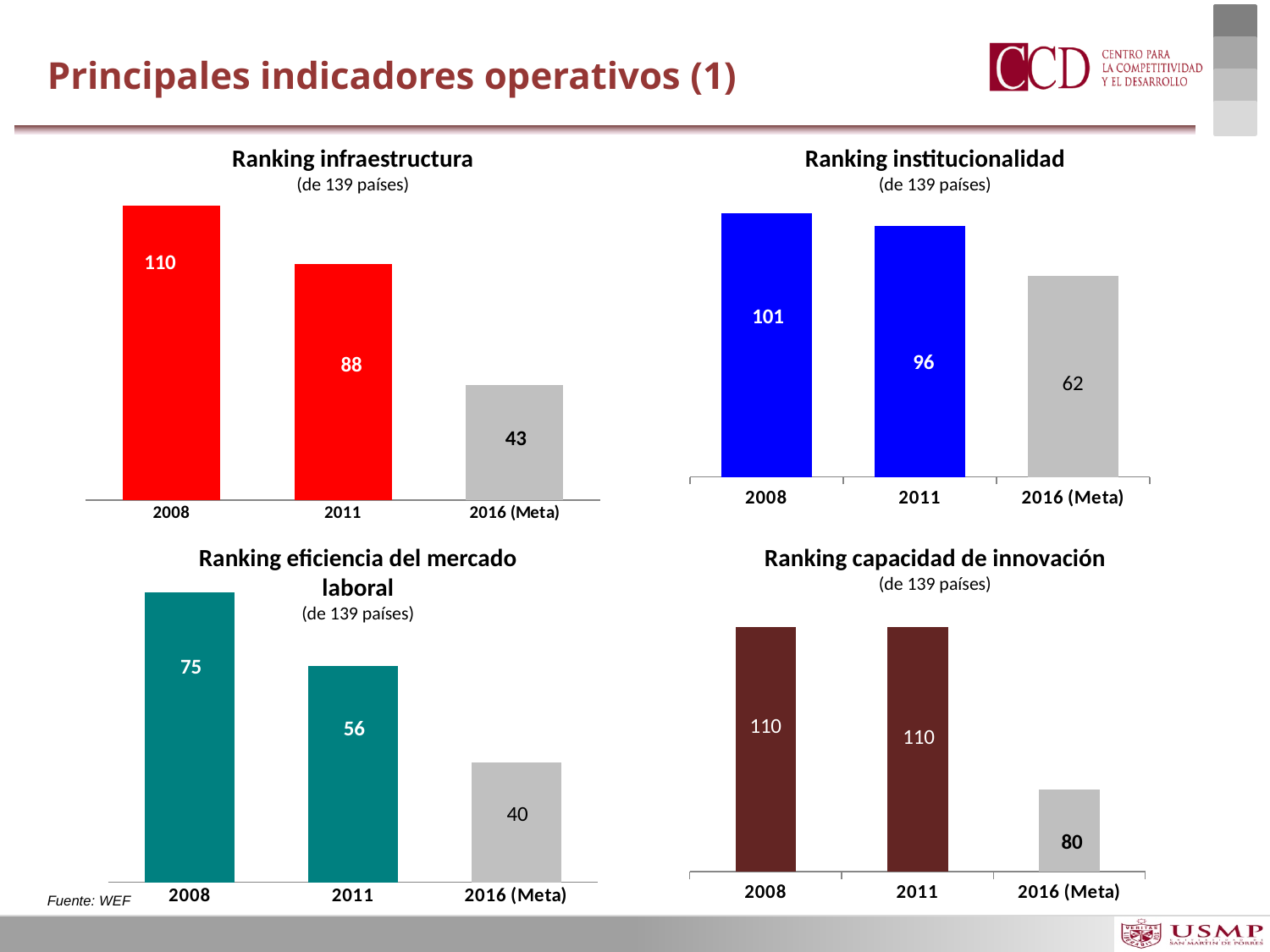
In the 'Ranking institucionalidad' chart, what is the difference between the 2008 and 2011 values? 5 What kind of chart is the 'Ranking capacidad de innovación' chart? Bar chart In the 'Ranking eficiencia del mercado laboral' chart, which year has the highest value? 2008 In the 'Ranking eficiencia del mercado laboral' chart, do the values rise or fall from 2008 to 2016 (Meta)? Fall How many categories are shown in the 'Ranking institucionalidad' chart? 3 In the 'Ranking capacidad de innovación' chart, what is the difference between the 2008 value and the 2016 (Meta) value? 30 In the 'Ranking institucionalidad' chart, what is the value for 2008? 101 In the 'Ranking infraestructura' chart, what is the value for 2011? 88 In the 'Ranking eficiencia del mercado laboral' chart, what is the value for 2016 (Meta)? 40 In the 'Ranking infraestructura' chart, what is the value for 2016 (Meta)? 43 In the 'Ranking infraestructura' chart, which is larger, the value for 2008 or the value for 2011? 2008 In the 'Ranking capacidad de innovación' chart, what is the value for 2016 (Meta)? 80